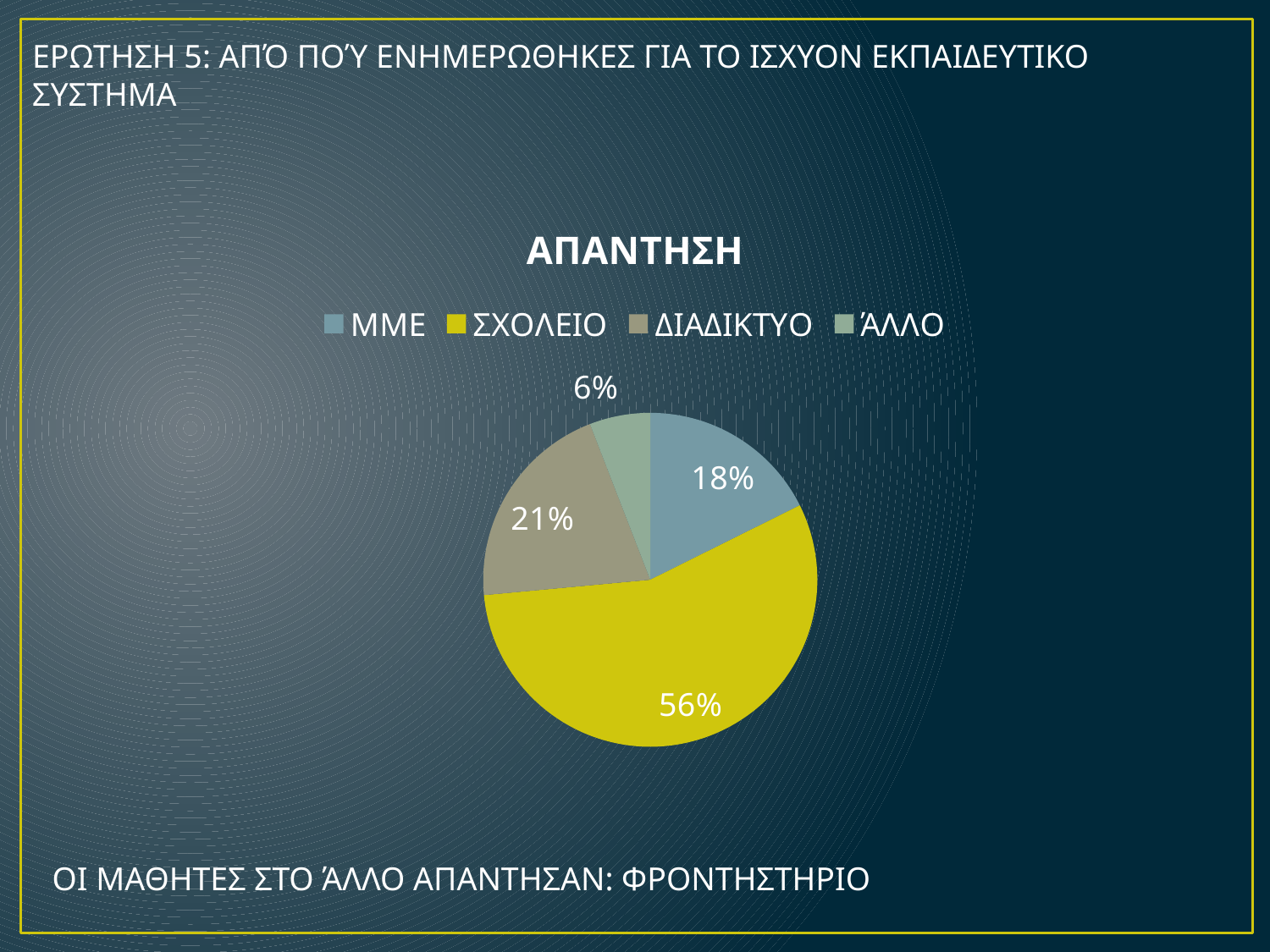
What is the difference in percentage points between ΣΧΟΛΕΙΟ and ΔΙΑΔΙΚΤΥΟ? 35 What kind of chart is shown on the slide? Pie chart Which is larger, the share for ΜΜΕ or the share for ΔΙΑΔΙΚΤΥΟ? ΔΙΑΔΙΚΤΥΟ How many categories does the pie chart show? 4 What share of the pie does ΔΙΑΔΙΚΤΥΟ have? 21% What colour is the ΣΧΟΛΕΙΟ slice? Yellow What is the title of the chart? ΑΠΑΝΤΗΣΗ Which category has the largest slice of the pie? ΣΧΟΛΕΙΟ Which category has the smallest slice of the pie? ΆΛΛΟ What share of the pie does ΜΜΕ have? 18% What share of the pie does ΆΛΛΟ have? 6%